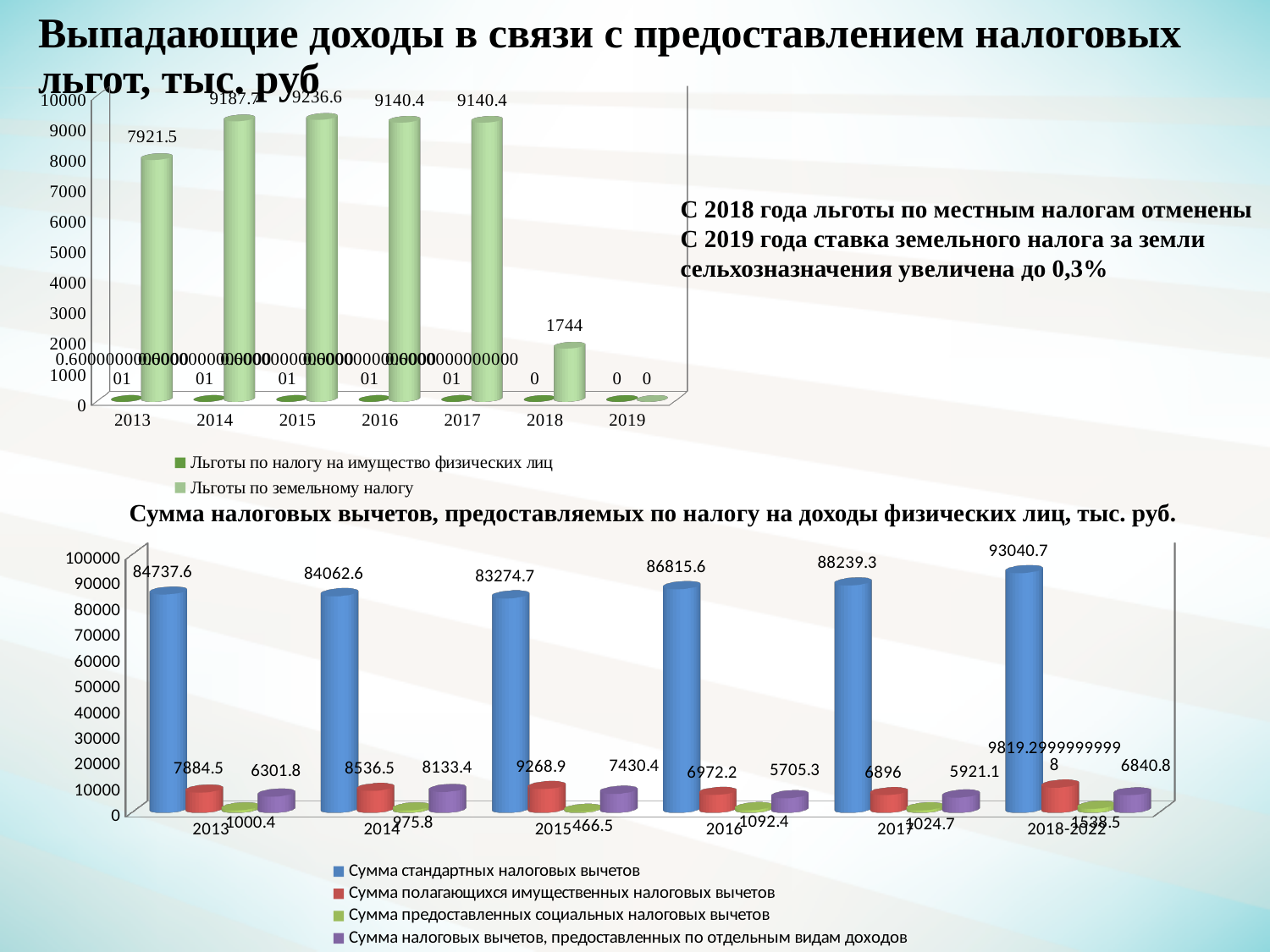
In the top chart (Выпадающие доходы в связи с предоставлением налоговых льгот), how many years are shown on the x axis? 7 What type of chart is the bottom chart (Сумма налоговых вычетов)? Bar chart In the bottom chart (Сумма налоговых вычетов), what is the difference between Сумма стандартных налоговых вычетов in 2017 and in 2016? 1423.7 In the bottom chart (Сумма налоговых вычетов), what is the value of Сумма стандартных налоговых вычетов for 2018-2022? 93040.7 In the top chart (Выпадающие доходы в связи с предоставлением налоговых льгот), what is the value of Льготы по земельному налогу for 2018? 1744 In the bottom chart (Сумма налоговых вычетов), what is the value of Сумма предоставленных социальных налоговых вычетов for 2015? 466.5 In the top chart (Выпадающие доходы в связи с предоставлением налоговых льгот), how many series does the legend list? 2 In the bottom chart (Сумма налоговых вычетов), which is larger in 2014: Сумма полагающихся имущественных налоговых вычетов or Сумма налоговых вычетов, предоставленных по отдельным видам доходов? Сумма полагающихся имущественных налоговых вычетов In the bottom chart (Сумма налоговых вычетов), which year has the lowest value of Сумма стандартных налоговых вычетов? 2015 In the top chart (Выпадающие доходы в связи с предоставлением налоговых льгот), what is the value of Льготы по земельному налогу for 2013? 7921.5 In the bottom chart (Сумма налоговых вычетов), how many series does the legend list? 4 In the top chart (Выпадающие доходы в связи с предоставлением налоговых льгот), which year has the highest value of Льготы по земельному налогу? 2015